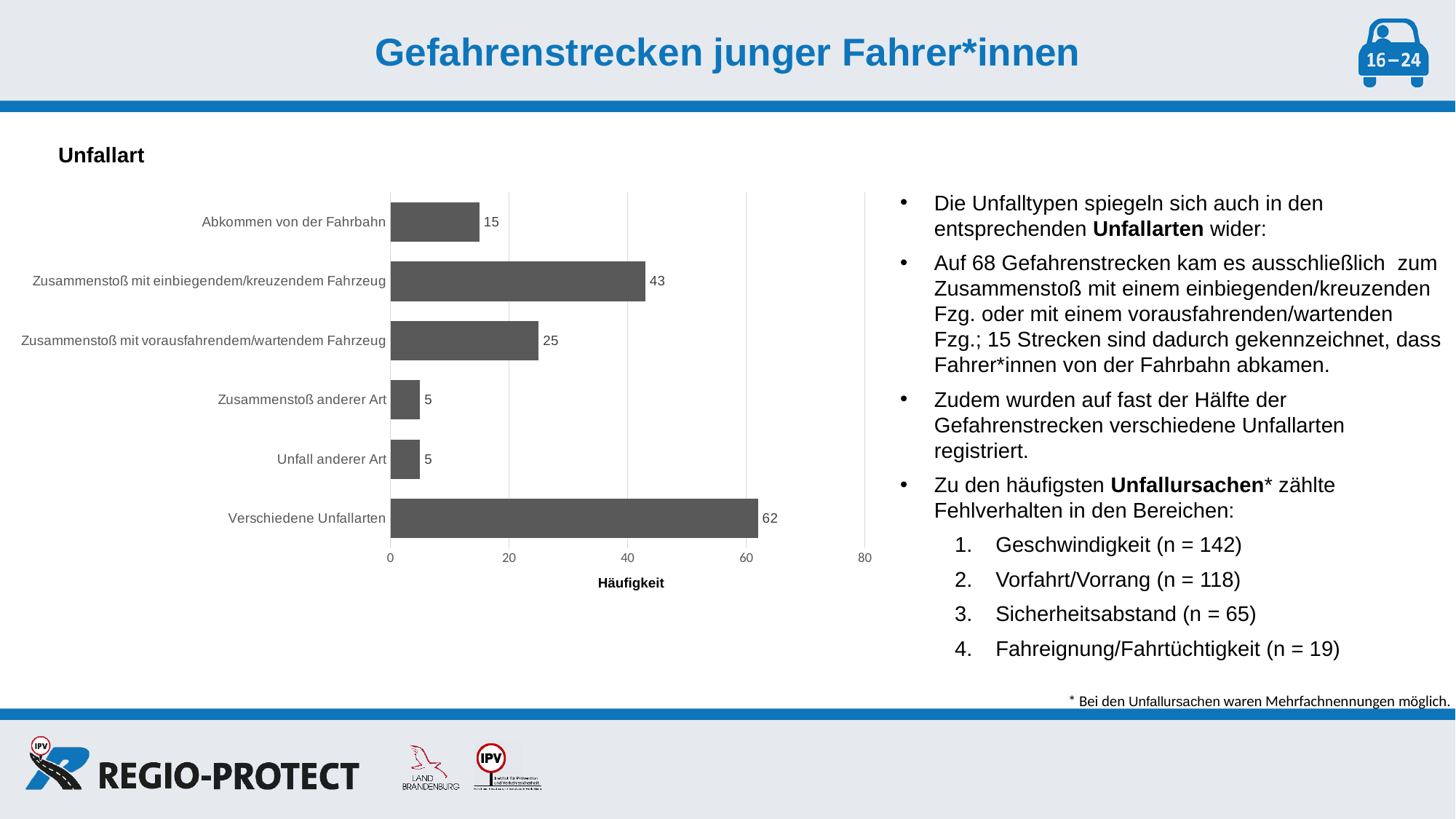
What is the value for "Abkommen von der Fahrbahn"? 15 What kind of chart is shown on the slide? bar chart What is the difference between "Verschiedene Unfallarten" and "Zusammenstoß mit einbiegendem/kreuzendem Fahrzeug"? 19 What is the difference between "Zusammenstoß mit einbiegendem/kreuzendem Fahrzeug" and "Zusammenstoß mit vorausfahrendem/wartendem Fahrzeug"? 18 Is the value for "Zusammenstoß mit einbiegendem/kreuzendem Fahrzeug" greater or less than 40? greater What is the value for "Zusammenstoß mit einbiegendem/kreuzendem Fahrzeug"? 43 What is the value for "Verschiedene Unfallarten"? 62 How many categories are shown in the chart? 6 What is the value for "Zusammenstoß mit vorausfahrendem/wartendem Fahrzeug"? 25 What is the label of the horizontal axis of the chart? Häufigkeit Which is larger: "Abkommen von der Fahrbahn" or "Zusammenstoß mit vorausfahrendem/wartendem Fahrzeug"? Zusammenstoß mit vorausfahrendem/wartendem Fahrzeug Which category has the highest value? Verschiedene Unfallarten